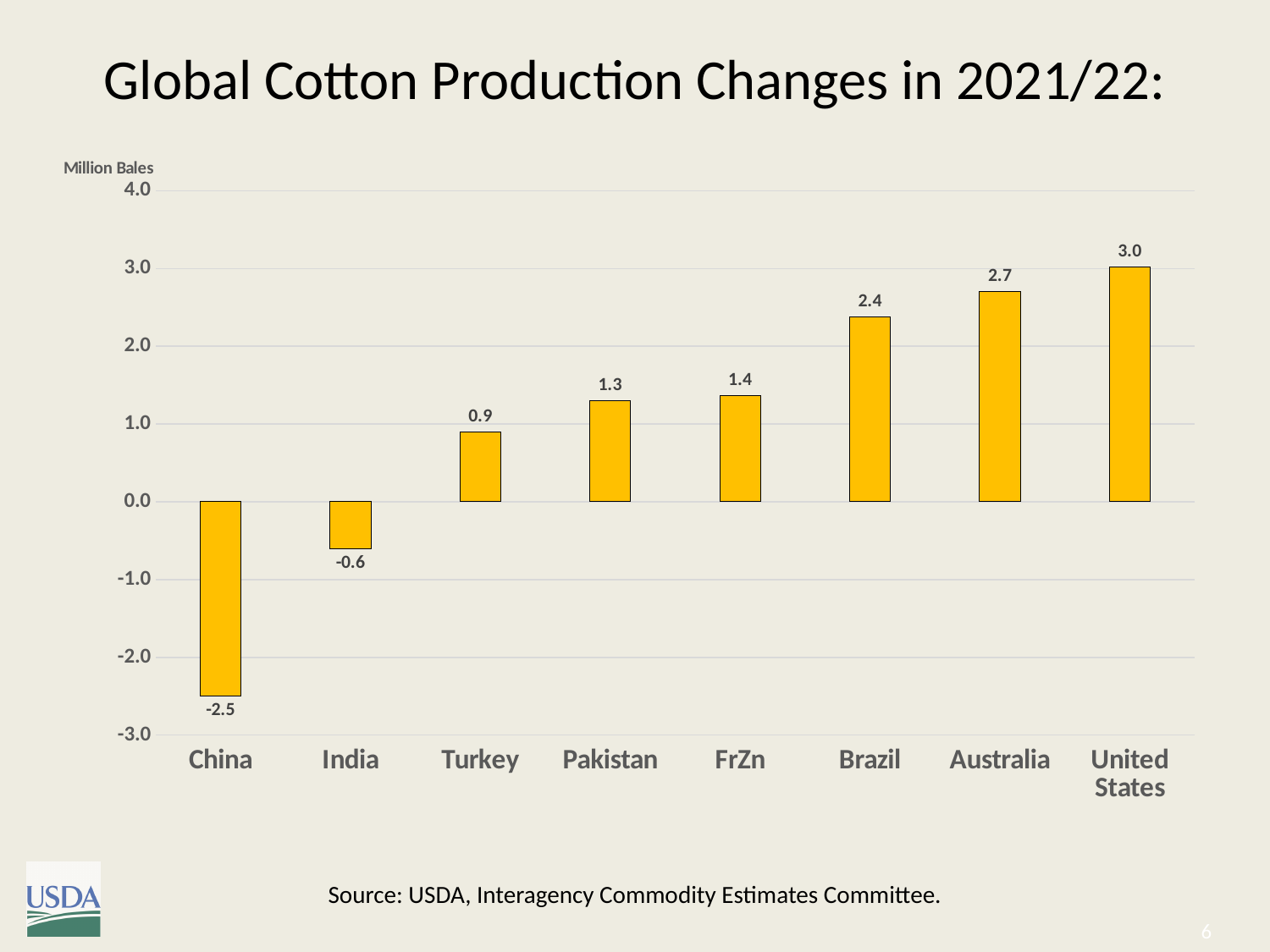
How many countries or regions are shown on the chart? 8 What kind of chart is shown on the slide? bar chart Which country has the lowest production change? China What is the production change for Brazil? 2.4 Do the values generally rise or fall from left to right across the x axis? rise What is the difference between the production changes for Australia and Turkey? 1.8 Which has a larger production change, Pakistan or Brazil? Brazil What unit is shown on the vertical axis label? Million Bales What is the production change for China? -2.5 What is the production change for FrZn? 1.4 Which country has the highest production change? United States Is the value for India greater or less than -1.0? greater